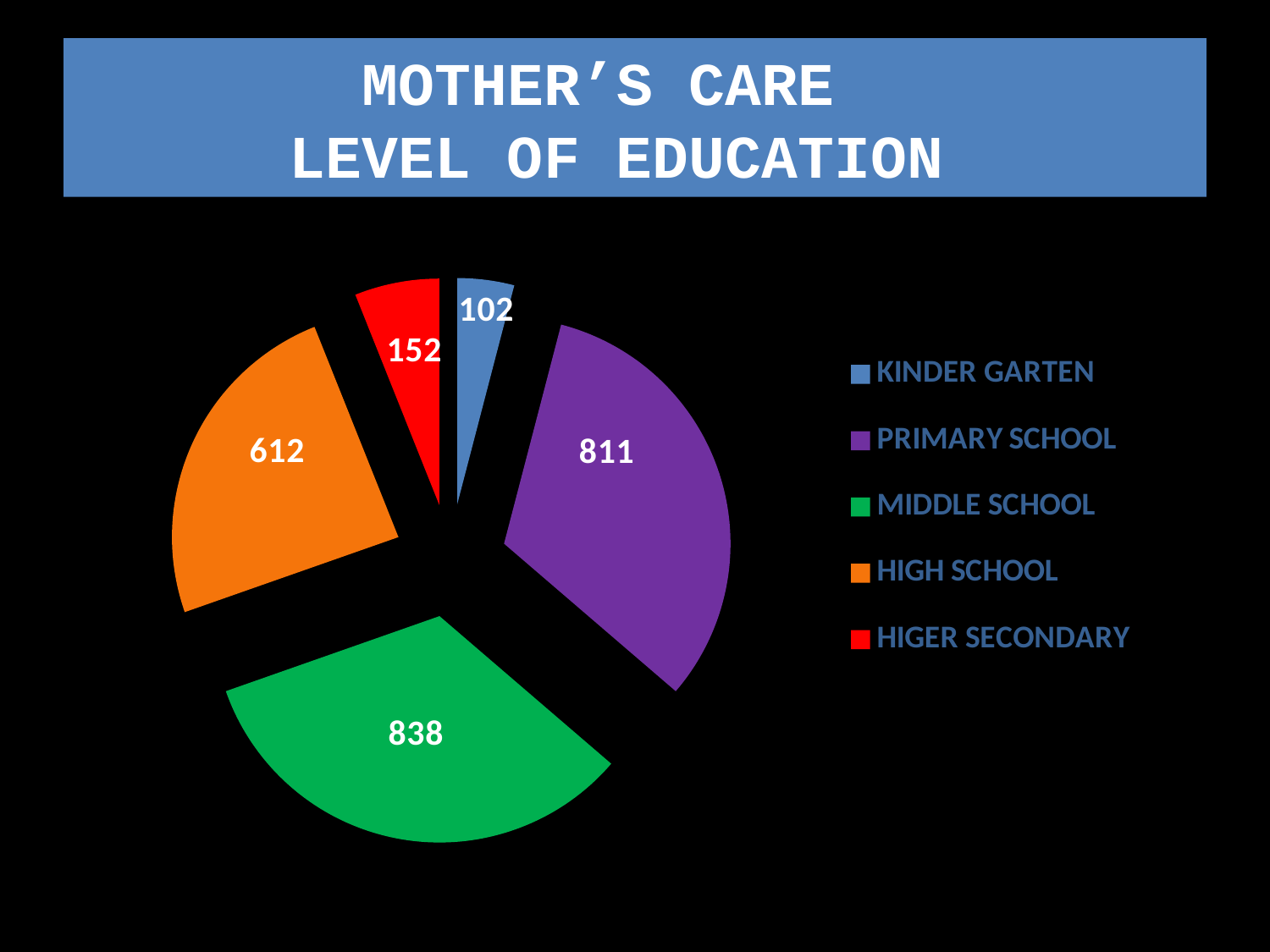
Which category has the lowest value? Kinder Garten Which is larger, the value for High School or the value for Higer Secondary? High School What is the title of the chart? Mother's Care Level of Education How many categories does the pie chart show? 5 What is the total of all the slices in the pie chart? 2515 What is the difference between the values for Middle School and Primary School? 27 What is the value for Kinder Garten? 102 Which category has the highest value? Middle School What is the value for Middle School? 838 What is the value for High School? 612 What kind of chart is shown on the slide? Pie chart What is the value for Higer Secondary? 152